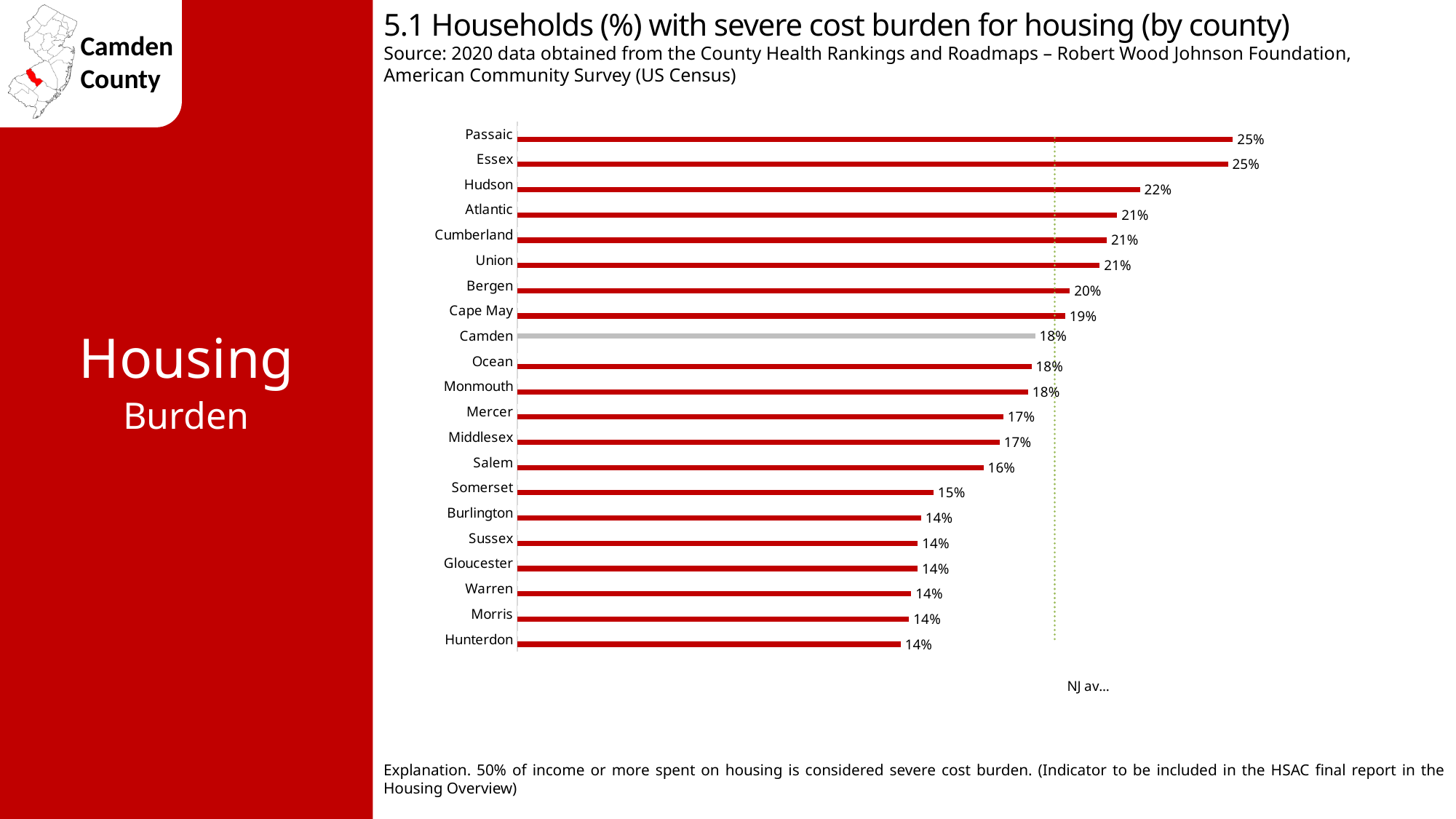
Which has a larger value, Atlantic or Mercer? Atlantic What is the value for Camden? 18% What is the difference between the values for Passaic and Camden? 7 percentage points What is the value for Somerset? 15% Which county's bar is shown in grey instead of red? Camden What is the value for Hudson? 22% How many counties are plotted in the chart? 21 What kind of chart is shown on the slide? bar chart What is the value for Bergen? 20% Which has a larger value, Cape May or Salem? Cape May What is the value for Salem? 16% What is the difference between the values for Hudson and Hunterdon? 8 percentage points